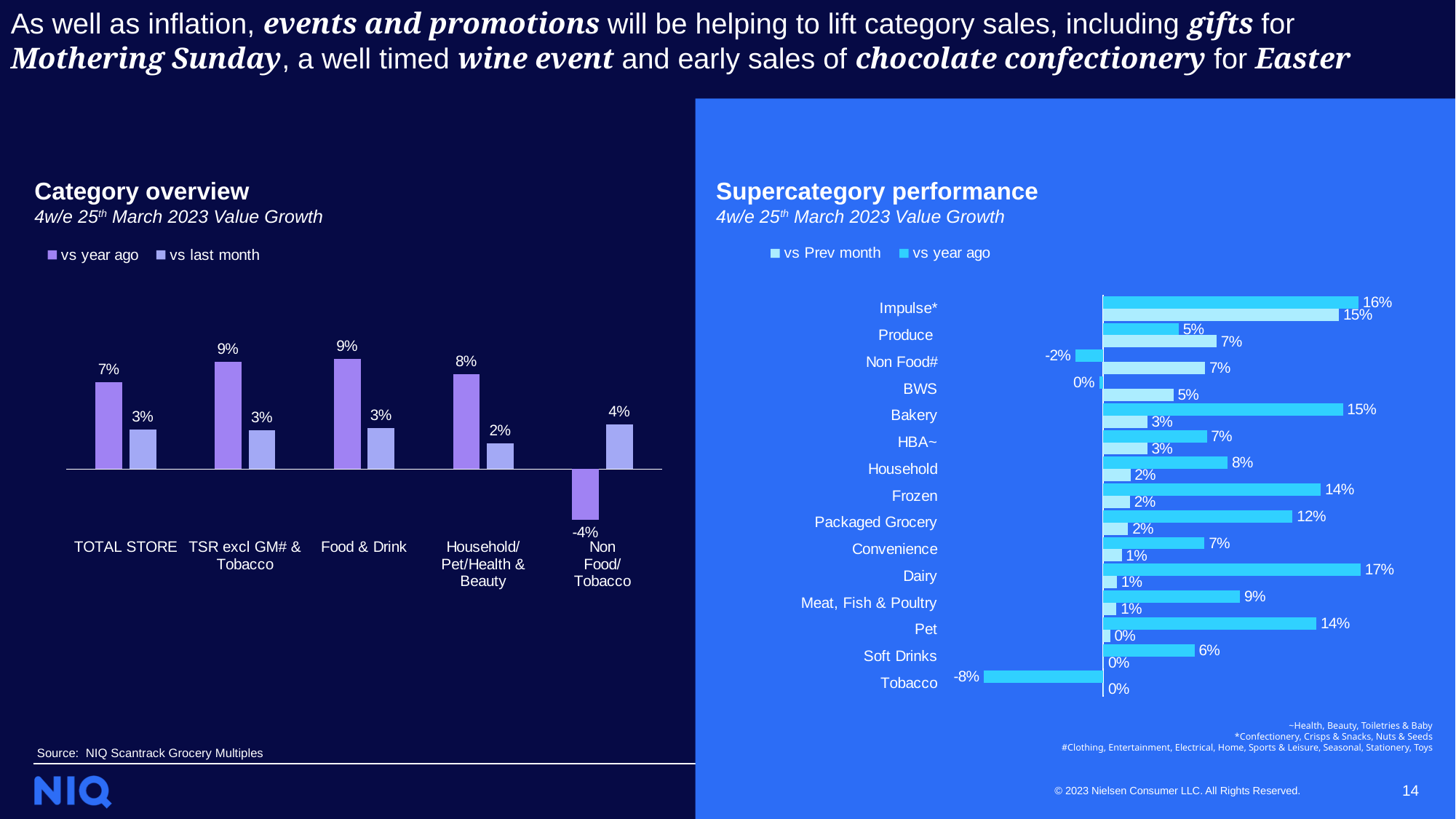
In the Supercategory performance chart, which supercategory has the highest vs year ago value? Dairy In the Category overview chart, which category has the lowest vs year ago value? Non Food/Tobacco In the Supercategory performance chart, how many supercategories are listed? 15 In the Category overview chart, what is the vs year ago value for TOTAL STORE? 7% In the Supercategory performance chart, which is larger: the vs year ago value for Bakery or for Packaged Grocery? Bakery What type of chart is the Supercategory performance chart? Bar chart In the Category overview chart, what is the vs last month value for Household/Pet/Health & Beauty? 2% In the Category overview chart, what is the difference between the vs year ago and vs last month values for Food & Drink? 6% In the Category overview chart, how many categories are shown on the x axis? 5 In the Category overview chart, how many series does the legend list? 2 In the Supercategory performance chart, what is the vs year ago value for Tobacco? -8% In the Supercategory performance chart, what is the vs year ago value for Frozen? 14%